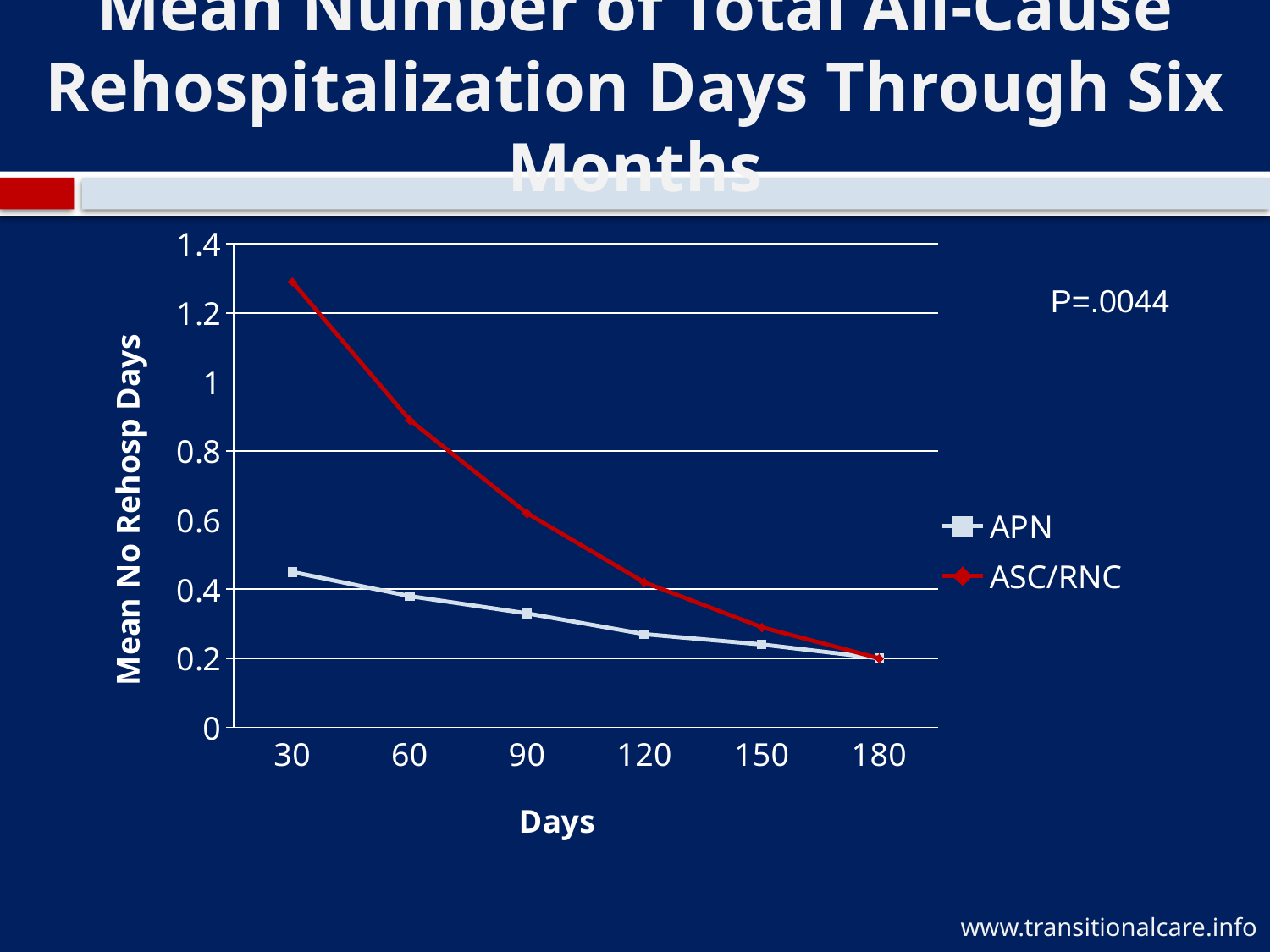
Is the value for APN at 90 days greater or less than 0.4? less How many series does the legend list? 2 Which series has the higher value at 30 days, APN or ASC/RNC? ASC/RNC At which number of days does the ASC/RNC series reach its highest value? 30 How many time points are plotted along the x axis? 6 What kind of chart is shown on the slide? Line chart Is the value for ASC/RNC at 60 days greater or less than 1? less Do the values for the ASC/RNC series rise or fall as the number of days increases? Fall What is the title of the y axis? Mean No Rehosp Days Is the value for ASC/RNC at 30 days greater or less than 1.2? greater What P value is shown on the chart? P=.0044